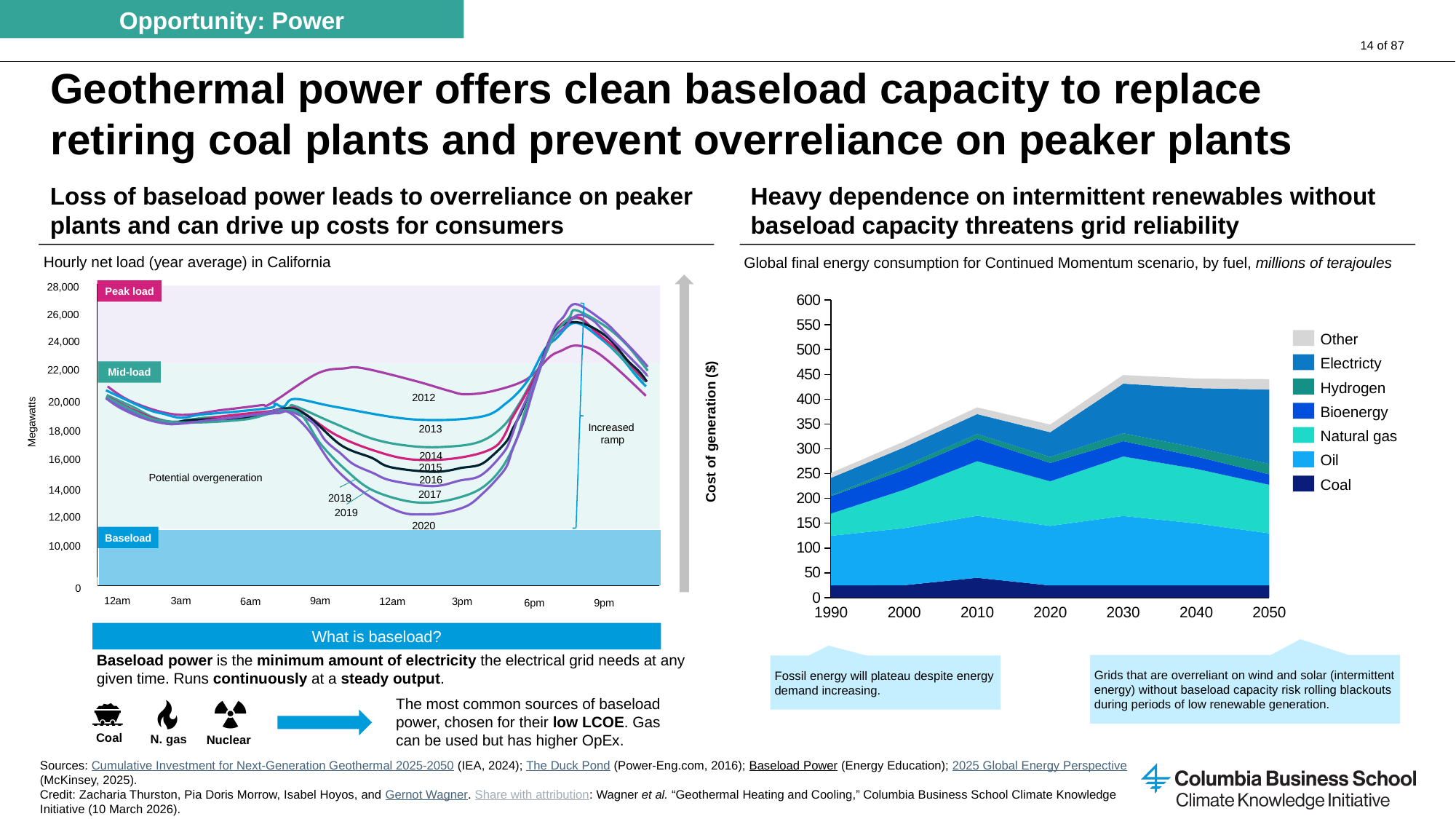
On the right chart, is the total energy consumption in 1990 greater or less than 300? less On the right chart, is the total energy consumption in 2030 greater or less than 400? greater What kind of chart is the left chart, 'Hourly net load (year average) in California'? line chart On the left chart, is the 2012 net load at 9am greater or less than 20,000 megawatts? greater How many years are labeled as separate lines on the left chart? 9 What kind of chart is the right chart, 'Global final energy consumption for Continued Momentum scenario, by fuel'? stacked area chart How many fuel categories does the legend of the right chart list? 7 What unit is used on the y axis of the left chart? Megawatts How many year ticks are shown on the x axis of the right chart? 7 On the right chart, which fuel is shown as the bottom layer of the stack? Coal On the right chart, does total energy consumption rise or fall between 1990 and 2030? rise